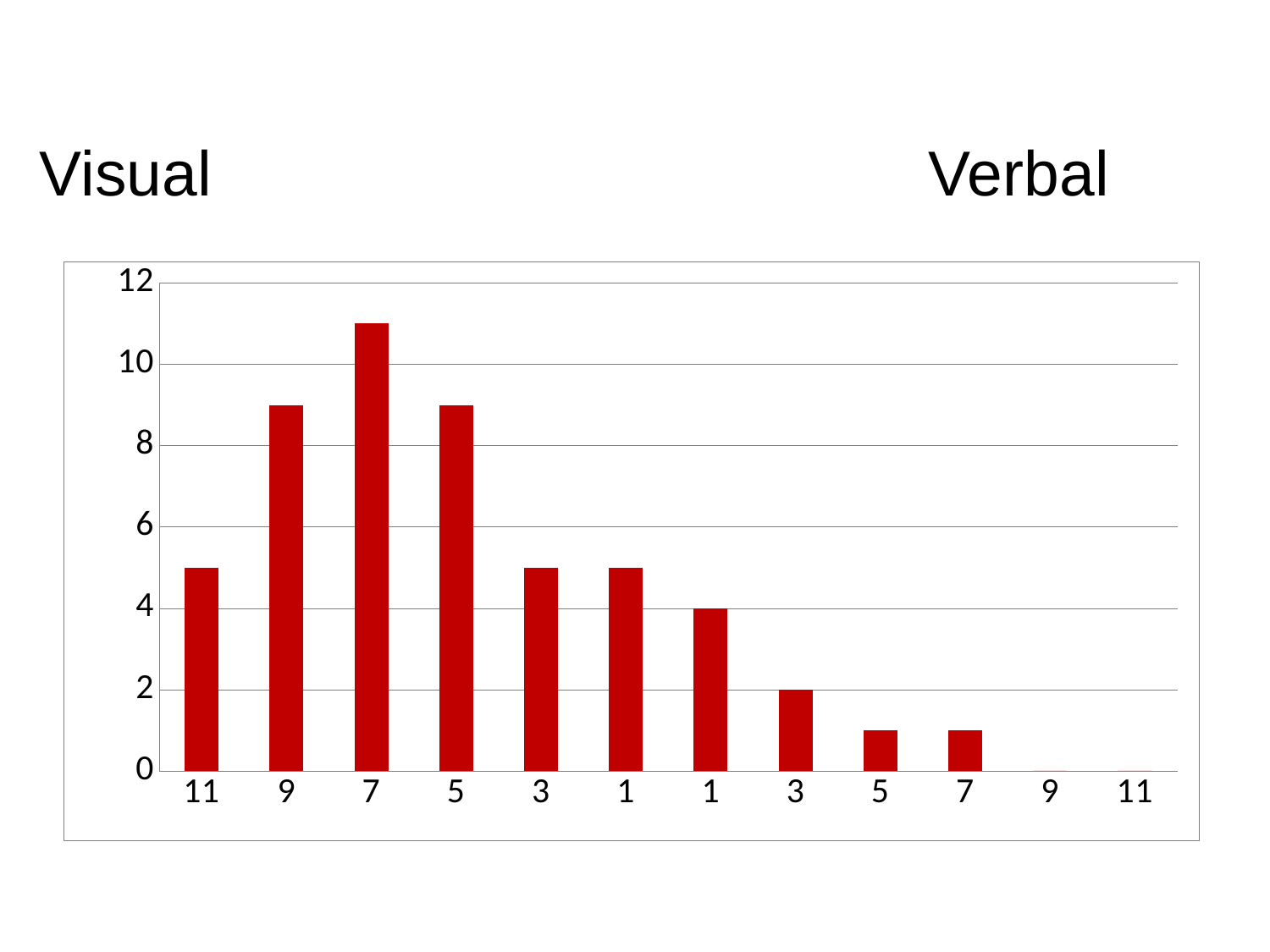
Is the value for category 11 on the Visual side greater or less than 6? less What is the difference between the bar for 1 on the Verbal side and the bar for 3 on the Verbal side? 2 What colour are the bars in the chart? red Is the value for category 9 on the Visual side greater or less than 8? greater How many bars (categories) are plotted along the x axis? 12 Moving from category 1 to category 11 on the Verbal side, do the bar values rise or fall? fall What is the value of the bar for category 1 on the Verbal side? 4 Which category has the tallest bar? 7 on the Visual side What kind of chart is shown on the slide? bar chart What is the value of the bar for category 3 on the Verbal side? 2 Which is larger: the bar for 9 on the Visual side or the bar for 11 on the Visual side? 9 on the Visual side Is the value for category 7 on the Visual side greater or less than 10? greater